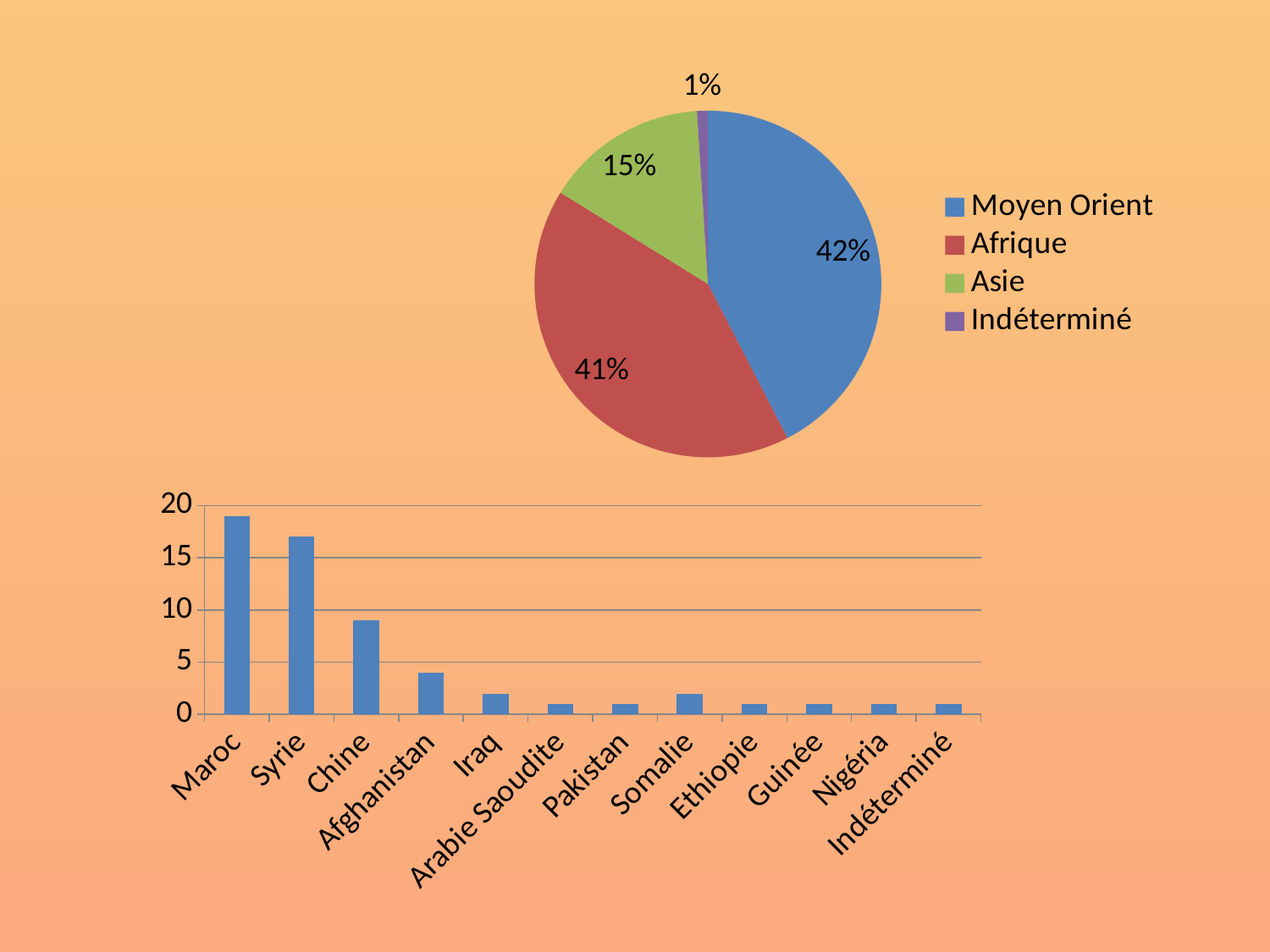
What kind of chart is shown at the bottom of the slide? Bar chart In the pie chart at the top of the slide, what share does Moyen Orient have? 42% In the bar chart at the bottom of the slide, which is larger, the value for Chine or the value for Afghanistan? Chine In the pie chart at the top of the slide, which colour represents Afrique? Red In the bar chart at the bottom of the slide, how many categories are shown on the x axis? 12 In the pie chart at the top of the slide, how many categories does the legend list? 4 In the bar chart at the bottom of the slide, which category has the highest value? Maroc In the pie chart at the top of the slide, what share does Asie have? 15% In the pie chart at the top of the slide, which category has the smallest share? Indéterminé In the pie chart at the top of the slide, what share does Afrique have? 41% In the pie chart at the top of the slide, what is the difference in percentage points between Moyen Orient and Asie? 27 In the bar chart at the bottom of the slide, is the value for Chine greater or less than 10? less